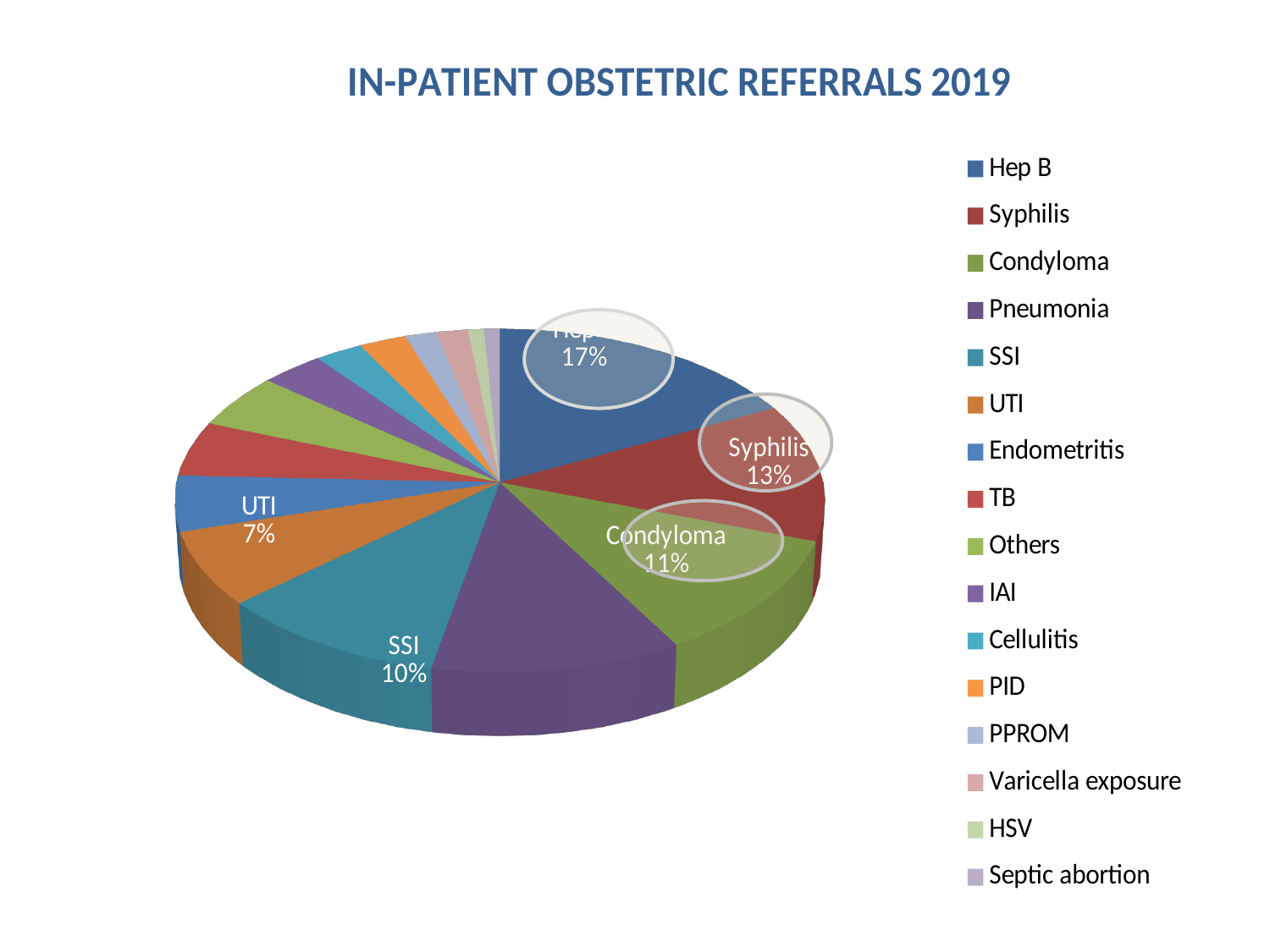
What is the difference between the Hep B share and the UTI share? 10% Which has the larger share, SSI or UTI? SSI What is the value shown for Condyloma? 11% How many categories are listed in the legend? 16 What percentage of the pie is labelled for Syphilis? 13% What is the title of the chart? IN-PATIENT OBSTETRIC REFERRALS 2019 What share of in-patient obstetric referrals in 2019 is Hep B? 17% What kind of chart is shown on the slide? Pie chart What percentage is shown for SSI? 10% Which is larger, the Syphilis slice or the Condyloma slice? Syphilis How many percentage points larger is the Hep B slice than the Syphilis slice? 4% What share of referrals is UTI? 7%